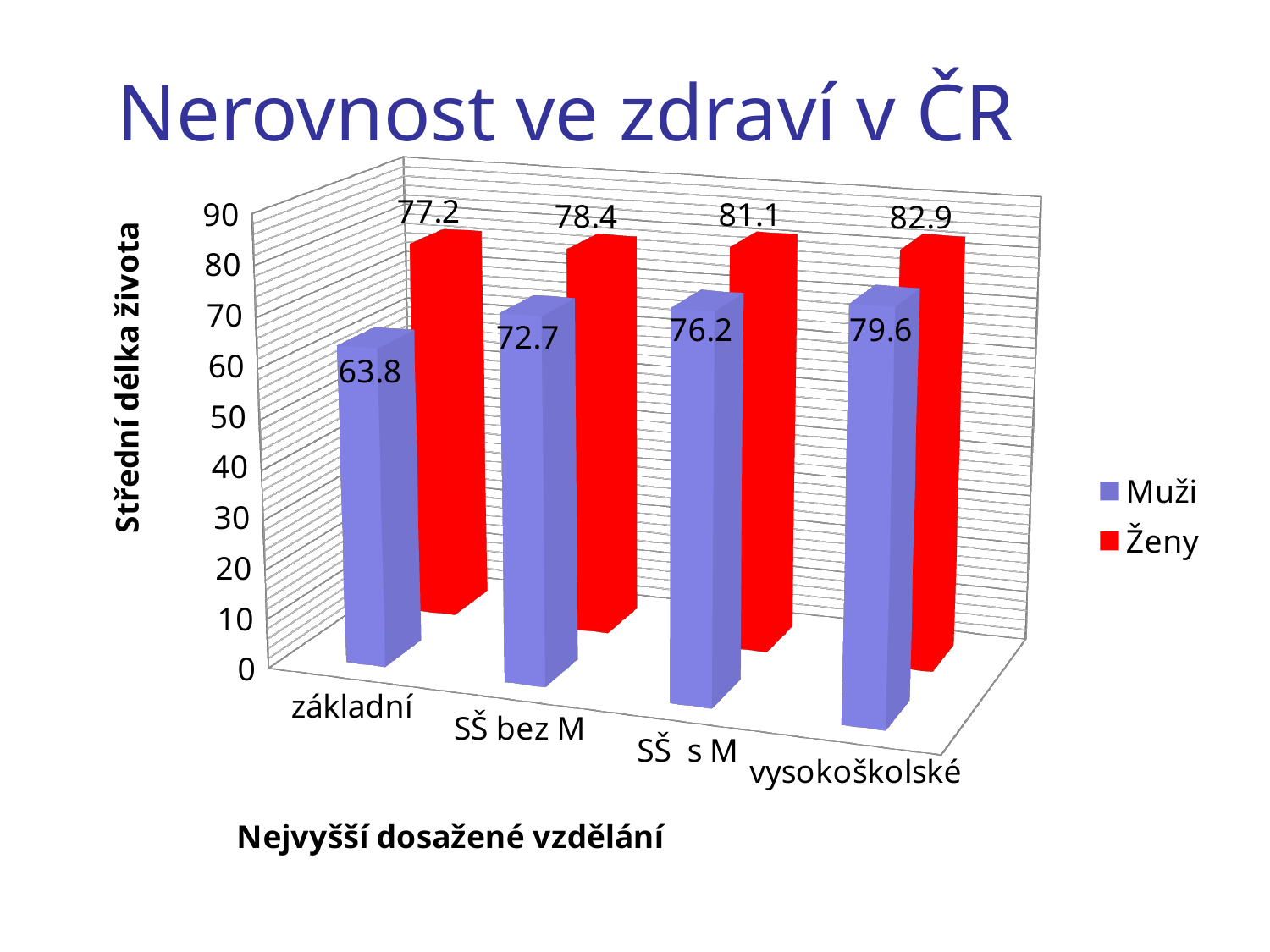
Do the Muži values rise or fall from základní to vysokoškolské? rise Which education category has the lowest value for Ženy? základní Which is larger: the Muži value for SŠ bez M or the Ženy value for základní? Ženy value for základní What is the value for Ženy in the vysokoškolské category? 82.9 What is the value for Muži in the SŠ s M category? 76.2 What kind of chart is shown on the slide? bar chart What is the value for Muži in the základní category? 63.8 How many education categories are shown on the x axis? 4 What is the difference between the Ženy and Muži values in the základní category? 13.4 What is the difference between the Muži values for vysokoškolské and SŠ bez M? 6.9 How many series does the legend list? 2 Which education category has the highest value for Muži? vysokoškolské